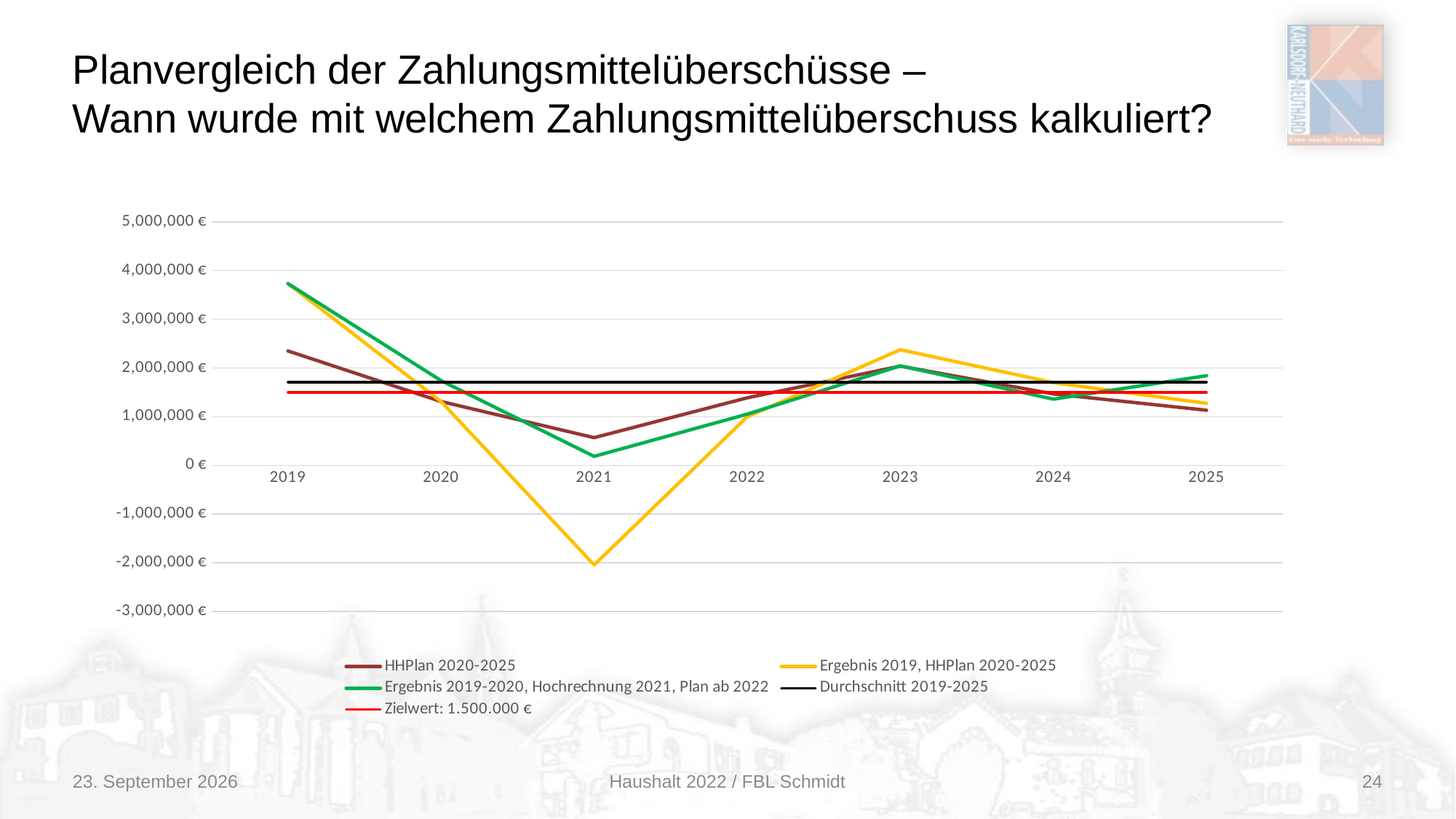
Is the 2019 value of 'Ergebnis 2019-2020, Hochrechnung 2021, Plan ab 2022' greater or less than 3,000,000 €? greater What kind of chart is shown on the slide? line chart How many years are shown on the x axis? 7 In which year does the series 'Ergebnis 2019, HHPlan 2020-2025' reach its highest value? 2019 How many series does the legend list? 5 Is the 2021 value of 'Ergebnis 2019, HHPlan 2020-2025' greater or less than -1,000,000 €? less Does the series 'HHPlan 2020-2025' rise or fall from 2019 to 2021? fall In which year does the series 'Ergebnis 2019, HHPlan 2020-2025' reach its lowest value? 2021 In which year does the series 'HHPlan 2020-2025' reach its lowest value? 2021 What value does the legend give for the Zielwert line? 1.500.000 € In 2021, which series has the larger value: 'HHPlan 2020-2025' or 'Ergebnis 2019, HHPlan 2020-2025'? HHPlan 2020-2025 Is the 2021 value of 'Ergebnis 2019-2020, Hochrechnung 2021, Plan ab 2022' greater or less than 1,000,000 €? less